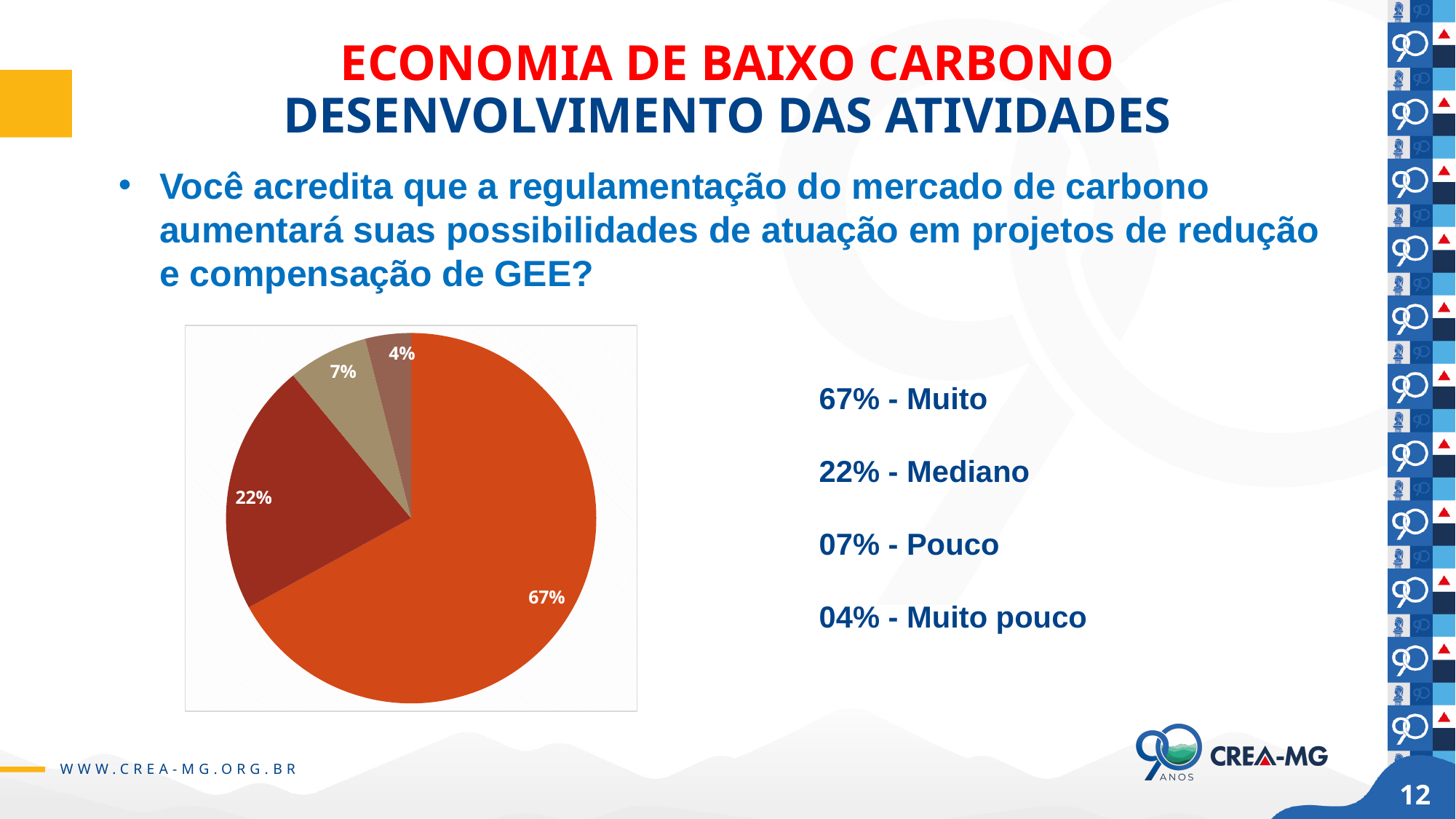
According to the slide, what share of respondents answered "Muito"? 67% What colour is the largest slice of the pie chart? orange-red What is the difference in percentage points between the 67% slice and the 22% slice? 45 According to the slide, what share of respondents answered "Muito pouco"? 04% What is the smallest slice of the pie chart? 4% Which is larger, the share for "Pouco" or the share for "Muito pouco"? Pouco What kind of chart is shown on the slide? pie chart According to the slide, what share of respondents answered "Pouco"? 07% What is the largest slice of the pie chart? 67% How many slices does the pie chart have? 4 According to the slide, what share of respondents answered "Mediano"? 22% What is the combined share of the 7% and 4% slices? 11%